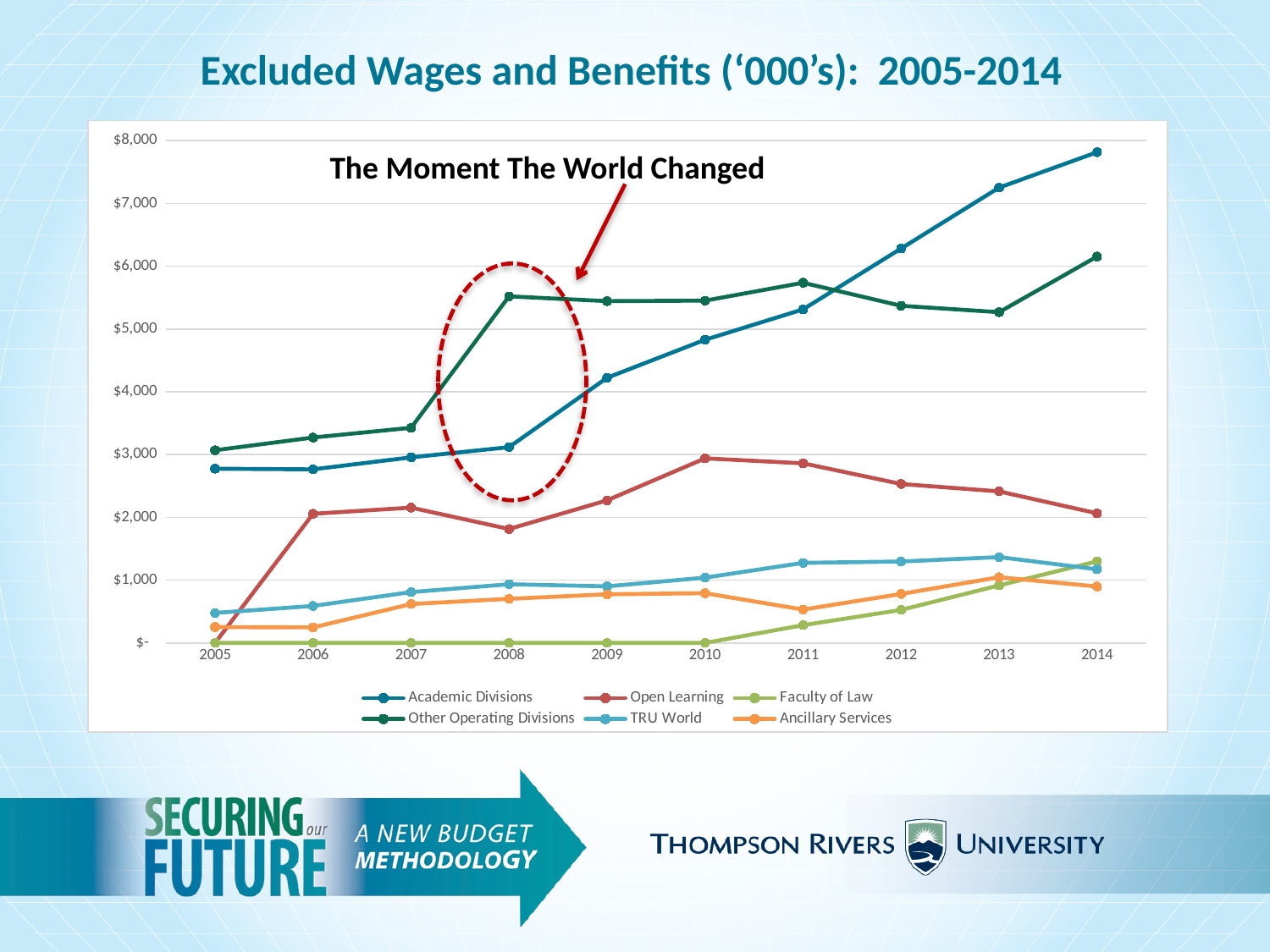
Which series has the highest value in 2014? Academic Divisions Is the value for Academic Divisions in 2014 greater or less than $7,000? greater How many years are plotted along the x axis? 10 Is the value for Other Operating Divisions in 2008 greater or less than $5,000? greater Which series has the lowest value in 2005? Faculty of Law and Open Learning (both at $-) What text does the annotation with the red arrow on the chart say? The Moment The World Changed What kind of chart is shown on the slide? line chart In 2010, which is larger: Academic Divisions or Other Operating Divisions? Other Operating Divisions Does the Open Learning line rise or fall from 2010 to 2014? fall How many series does the legend list? 6 Is the value for Open Learning in 2010 greater or less than $2,000? greater Does the Academic Divisions line rise or fall from 2005 to 2014? rise